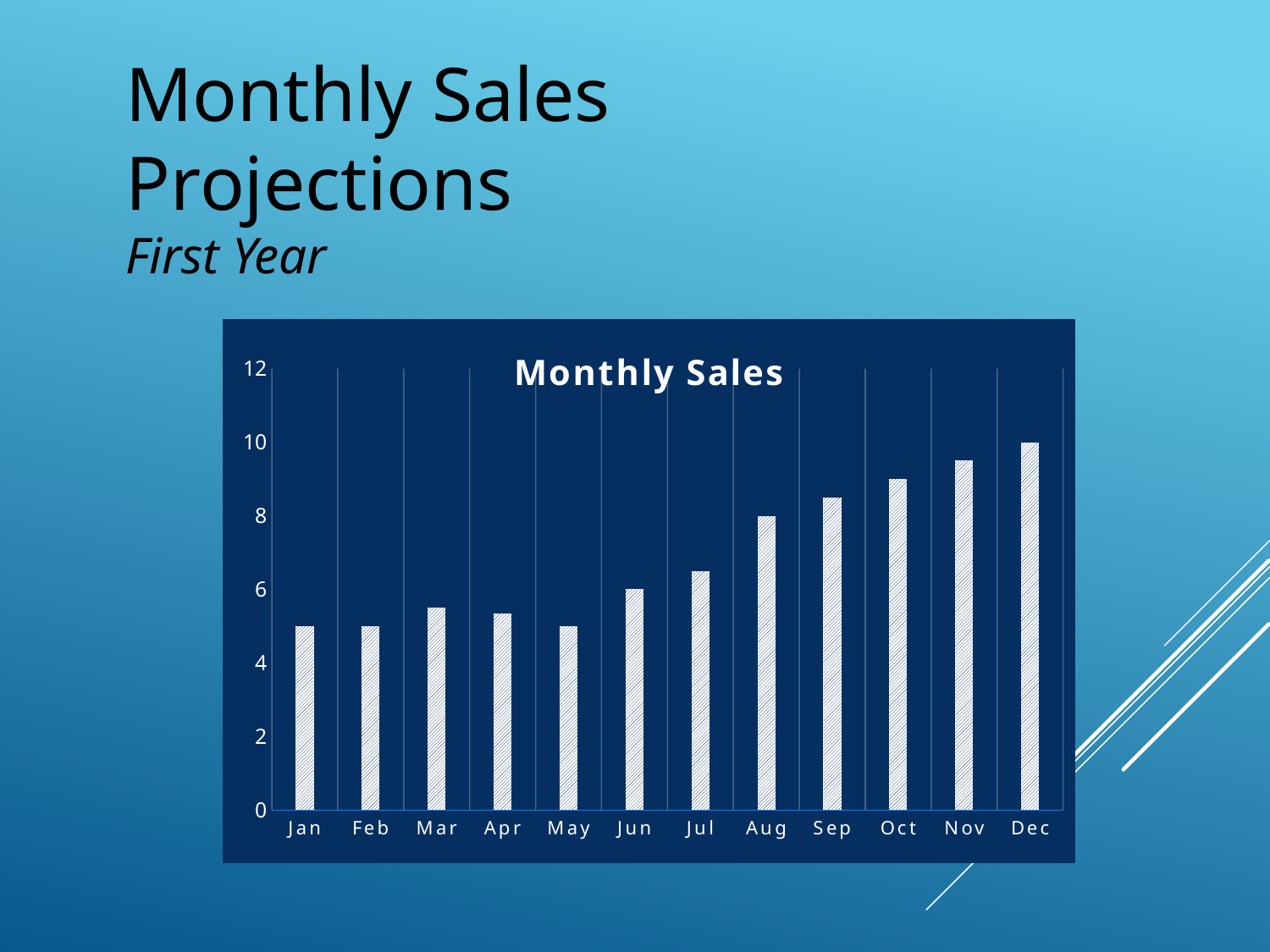
Is the value for Feb greater or less than 8? less What kind of chart is shown on the slide? bar chart Do the values generally rise or fall from Jan to Dec? rise Which month has the highest bar in the chart? Dec Is the value for Aug greater or less than 6? greater How many months are plotted on the x axis of the chart? 12 What is the title of the chart? Monthly Sales Is the value for Nov greater or less than 8? greater Which is larger, the value for Dec or the value for Jan? Dec Which is larger, the value for Mar or the value for Sep? Sep